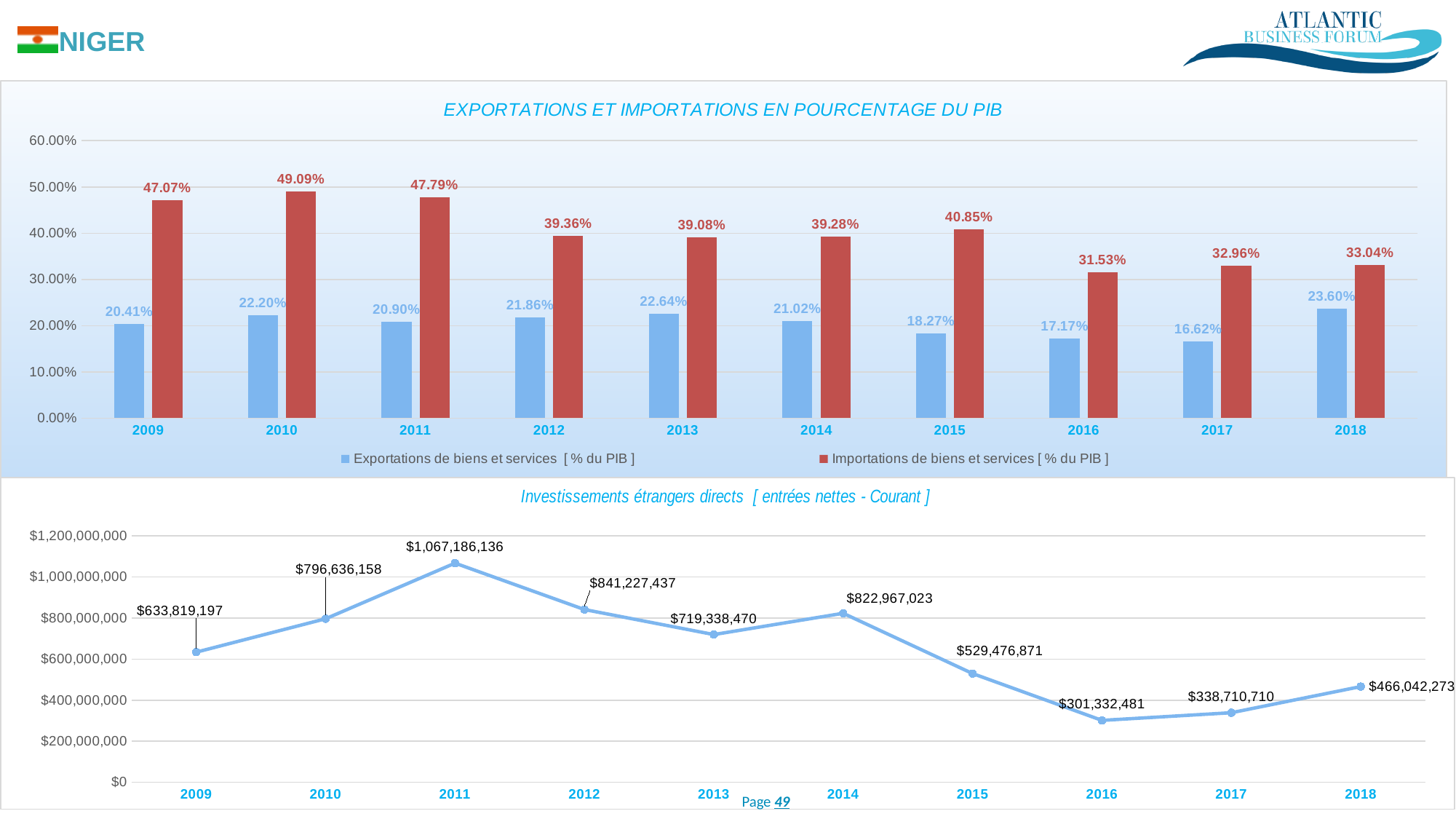
In the 'EXPORTATIONS ET IMPORTATIONS EN POURCENTAGE DU PIB' chart, how many series does the legend list? 2 In the 'Investissements étrangers directs' chart, which year has the lowest value? 2016 In the 'EXPORTATIONS ET IMPORTATIONS EN POURCENTAGE DU PIB' chart, which year has the lowest Importations value? 2016 In the 'EXPORTATIONS ET IMPORTATIONS EN POURCENTAGE DU PIB' chart, what is the value of Importations de biens et services for 2010? 49.09% What type of chart is the 'EXPORTATIONS ET IMPORTATIONS EN POURCENTAGE DU PIB' chart? Bar chart In the 'EXPORTATIONS ET IMPORTATIONS EN POURCENTAGE DU PIB' chart, what is the value of Exportations de biens et services for 2017? 16.62% In the 'Investissements étrangers directs' chart, what is the value for 2011? $1,067,186,136 In the 'EXPORTATIONS ET IMPORTATIONS EN POURCENTAGE DU PIB' chart, what is the difference between Importations and Exportations in 2009? 26.66% In the 'Investissements étrangers directs' chart, how many years are plotted? 10 In the 'EXPORTATIONS ET IMPORTATIONS EN POURCENTAGE DU PIB' chart, which year has the highest Exportations value? 2018 What type of chart is the 'Investissements étrangers directs' chart? Line chart In the 'Investissements étrangers directs' chart, is the value for 2015 larger or smaller than the value for 2014? Smaller